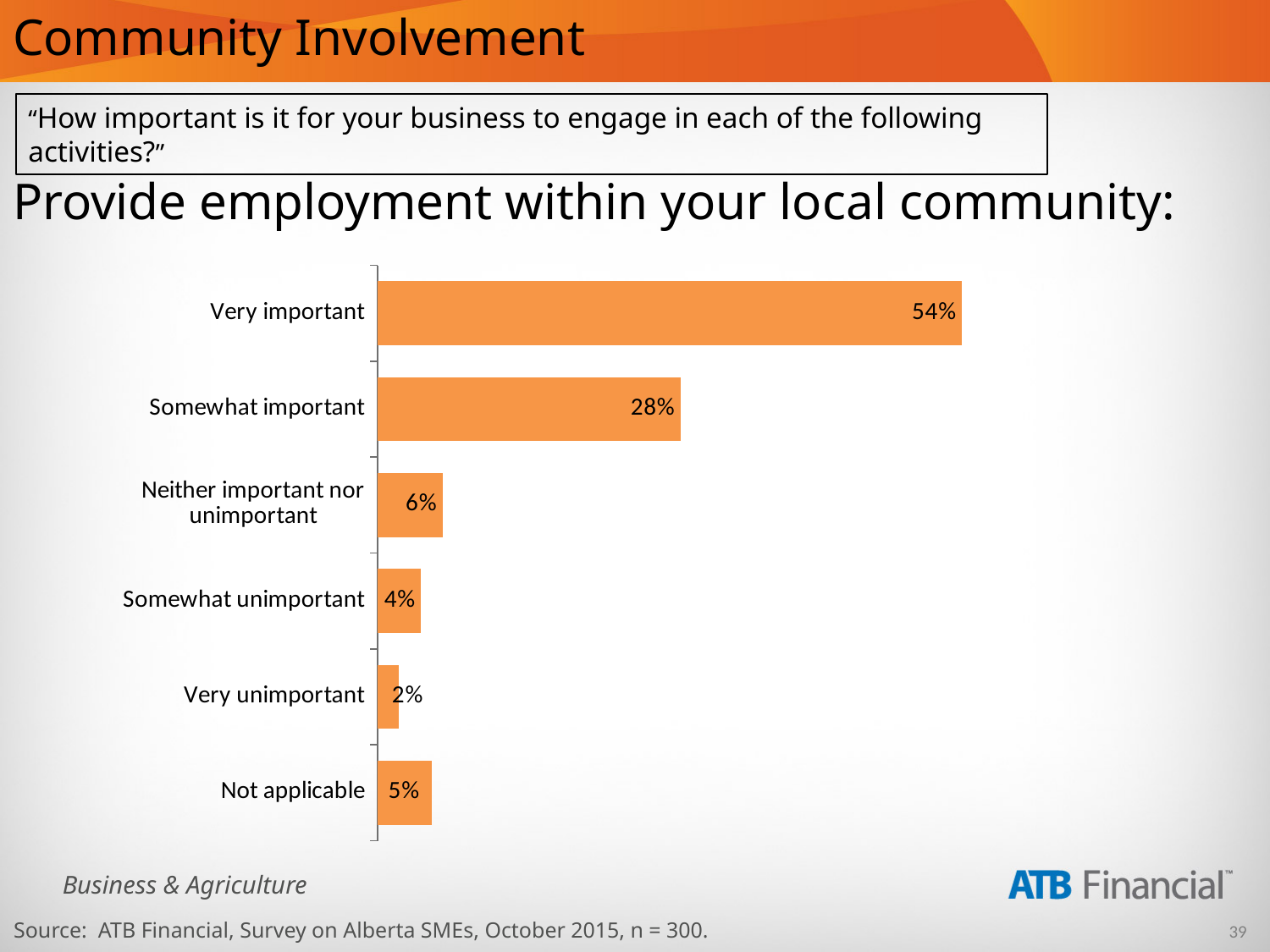
Which category has the highest value? Very important What activity does the chart on this slide ask about? Provide employment within your local community What is the combined value of 'Somewhat unimportant' and 'Very unimportant'? 6% How many categories are shown in the chart? 6 What is the difference between the 'Very important' and 'Somewhat important' values? 26% Which is larger: 'Somewhat unimportant' or 'Not applicable'? Not applicable Which category has the lowest value? Very unimportant What is the value for 'Somewhat important'? 28% What is the value for 'Not applicable'? 5% What is the value for 'Neither important nor unimportant'? 6% What kind of chart is shown on the slide? Bar chart What percentage of respondents said providing employment within the local community is 'Very important'? 54%